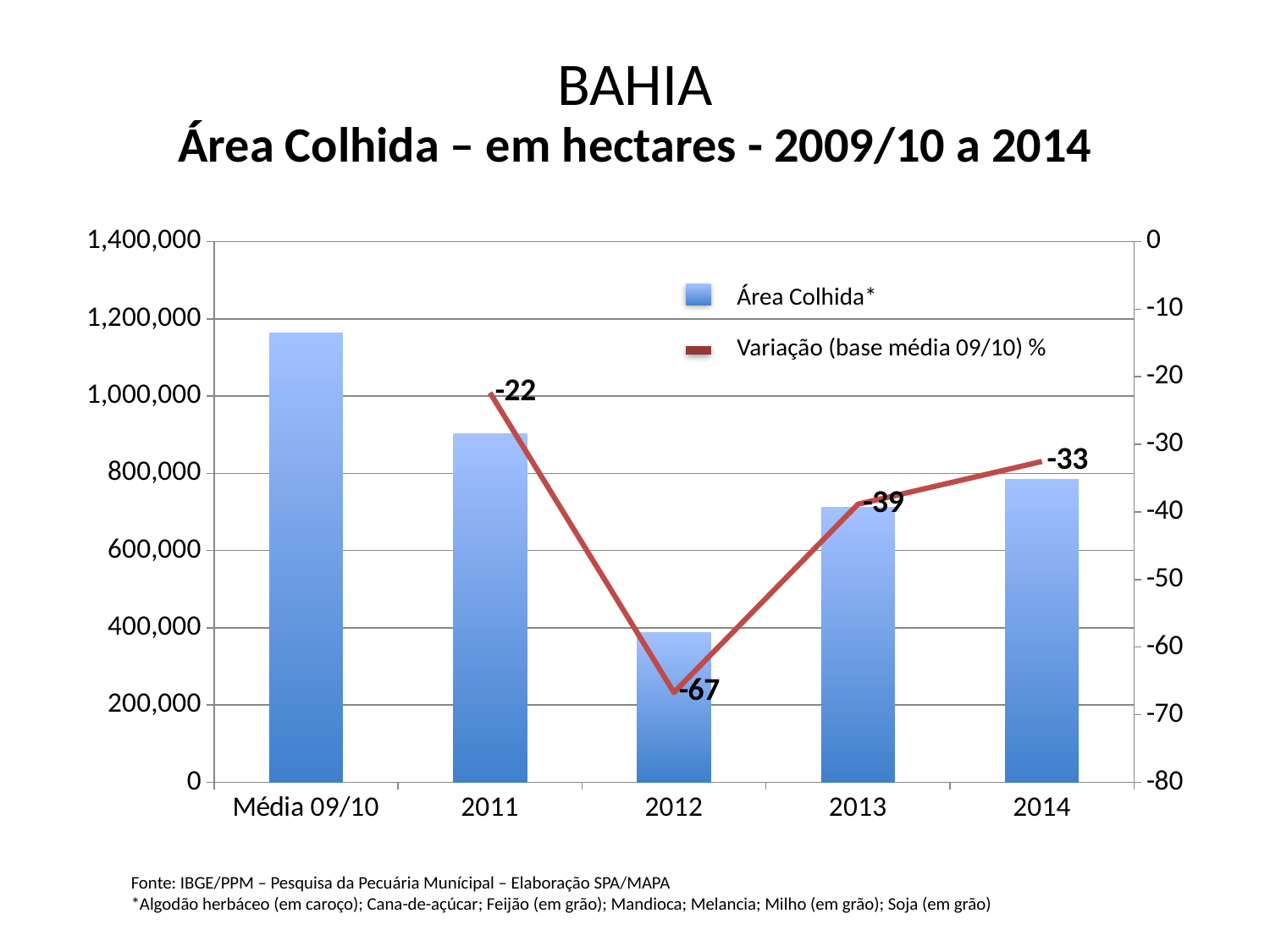
Is the Área Colhida bar for 2011 larger or smaller than the bar for 2012? larger What is the value of Variação (base média 09/10) % for 2012? -67 What is the value of Variação (base média 09/10) % for 2014? -33 Is the Área Colhida value for Média 09/10 greater or less than 1,000,000? greater Which year has the lowest Variação (base média 09/10) % value? 2012 How many categories are shown on the x axis? 5 Which category has the highest Área Colhida bar? Média 09/10 How many series does the legend list? 2 Which year has the lowest Área Colhida bar? 2012 What is the difference between the Variação values for 2011 and 2012? 45 What is the value of Variação (base média 09/10) % for 2011? -22